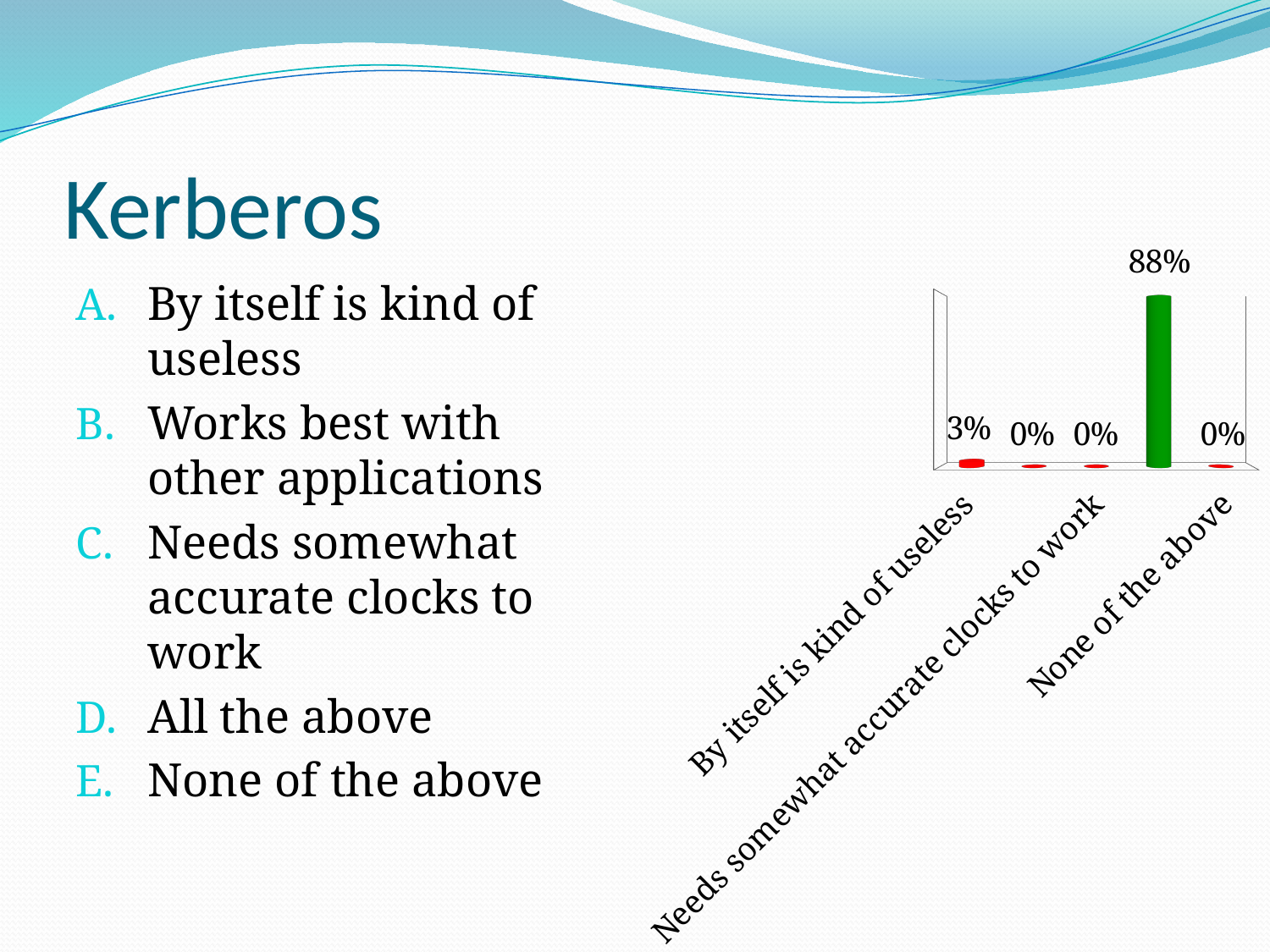
What is the difference between the highest value in the chart and the value for "By itself is kind of useless"? 85% How many bars are plotted in the chart? 5 What kind of chart is shown on the slide? Bar chart What colour is the bar for "By itself is kind of useless"? Red What is the lowest value shown in the chart? 0% What is the value for "Needs somewhat accurate clocks to work"? 0% Which is larger, the value for "By itself is kind of useless" or the value for "None of the above"? By itself is kind of useless What is the value for "None of the above"? 0% What is the value for "By itself is kind of useless"? 3% What colour is the tallest bar in the chart? Green What is the highest value shown in the chart? 88% What is the difference between the value for "By itself is kind of useless" and the value for "None of the above"? 3%